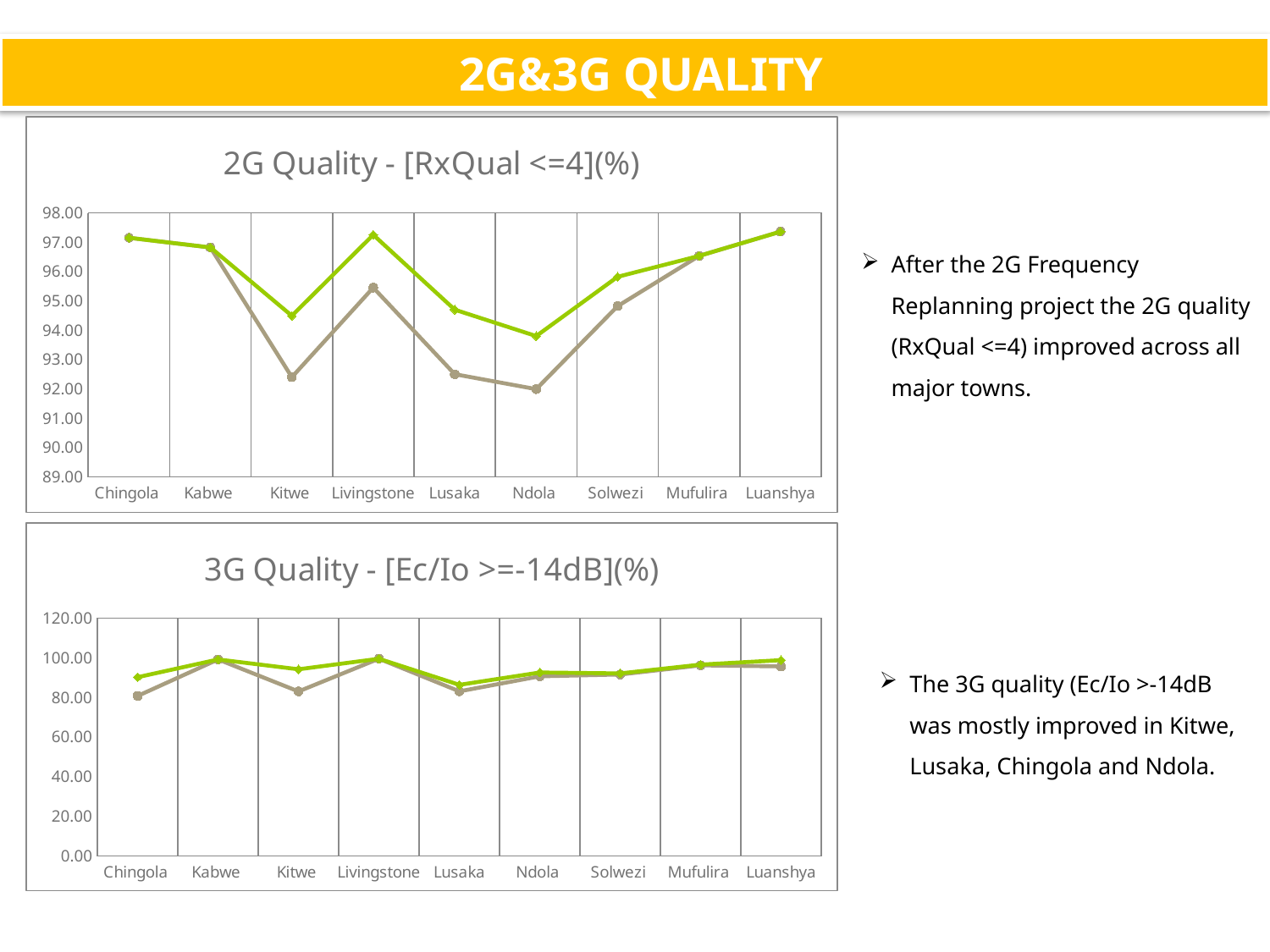
In the '2G Quality - [RxQual <=4](%)' chart, at Kitwe, which line is higher, the green line or the brown line? the green line In the '2G Quality - [RxQual <=4](%)' chart, at which town is the green line at its lowest? Ndola How many towns are shown on the x axis of the '2G Quality - [RxQual <=4](%)' chart? 9 In the '3G Quality - [Ec/Io >=-14dB](%)' chart, at Chingola, which line is higher, the green line or the brown line? the green line What kind of chart is the top chart titled '2G Quality - [RxQual <=4](%)'? line chart In the '3G Quality - [Ec/Io >=-14dB](%)' chart, is the brown line's value for Chingola greater or less than 100.00? less In the '2G Quality - [RxQual <=4](%)' chart, is the green line's value for Kitwe greater or less than 94.00? greater In the '2G Quality - [RxQual <=4](%)' chart, is the green line's value for Livingstone greater or less than 97.00? greater In the '2G Quality - [RxQual <=4](%)' chart, does the green line rise or fall from Ndola to Luanshya? rise How many towns are shown on the x axis of the '3G Quality - [Ec/Io >=-14dB](%)' chart? 9 What is the title of the bottom chart on the slide? 3G Quality - [Ec/Io >=-14dB](%)